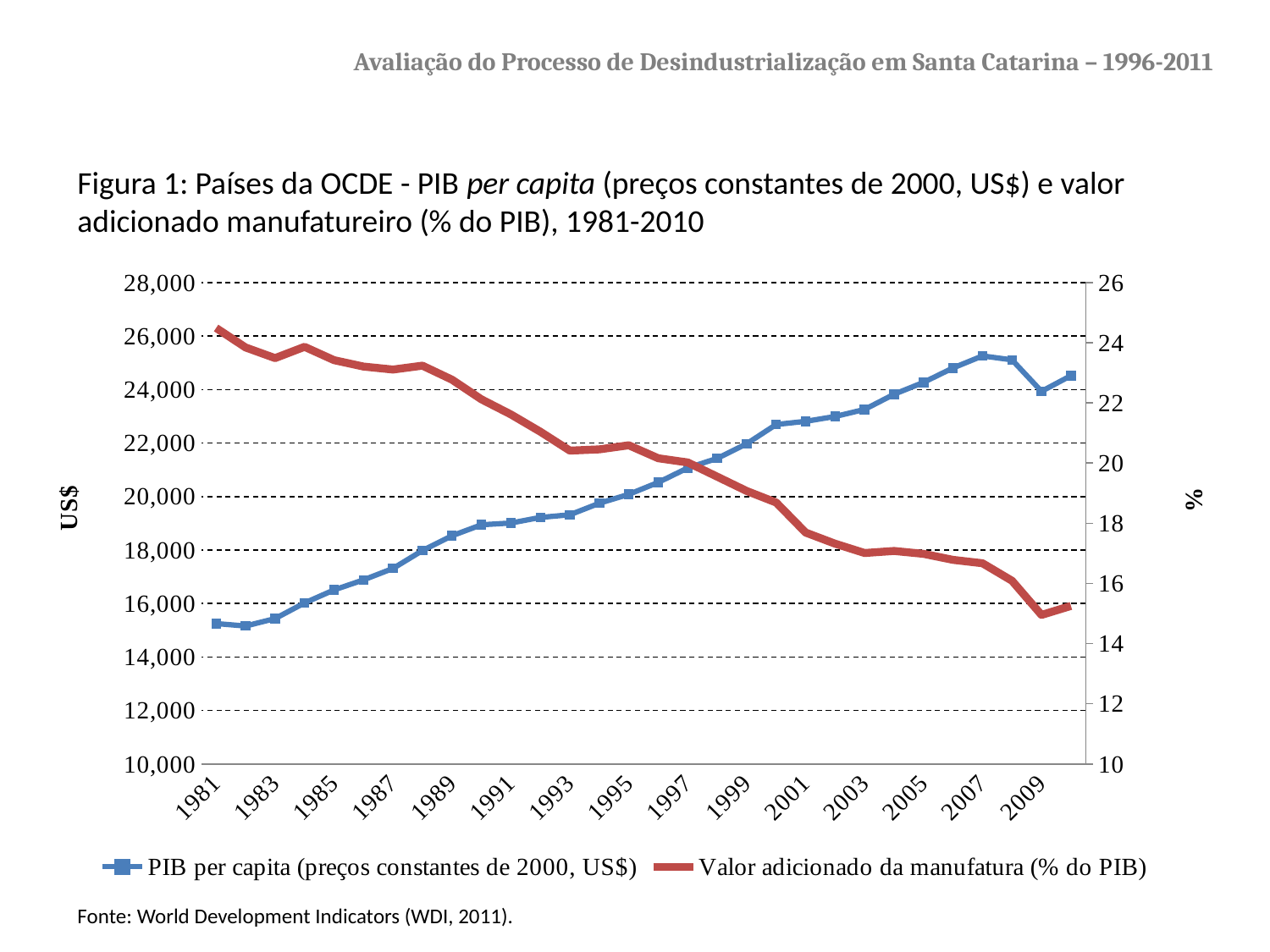
How many series does the legend list? 2 Is the PIB per capita value for 1981 greater or less than 16,000? less Is the PIB per capita value for 1993 greater or less than 20,000? less What is the label of the left vertical axis? US$ Is the PIB per capita value for 2007 greater or less than 24,000? greater In which year does the PIB per capita series reach its highest value? 2007 Does the Valor adicionado da manufatura (% do PIB) series rise or fall overall from 1981 to 2010? fall Which year has the larger PIB per capita value, 2008 or 2009? 2008 Does the PIB per capita series rise or fall overall from 1981 to 2010? rise What kind of chart is shown on the slide? line chart